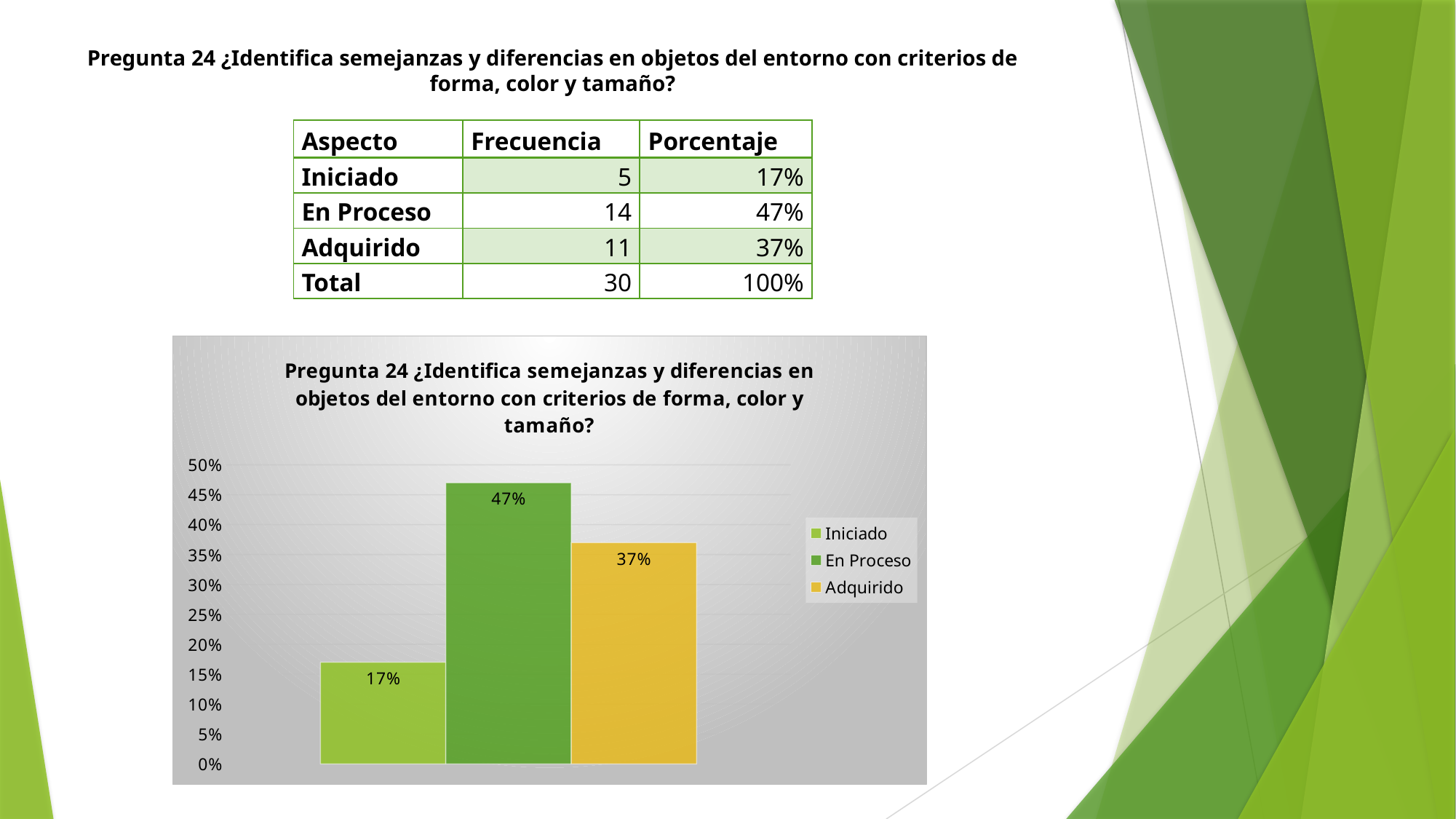
Is the value for En Proceso greater or less than 40%? greater Which is larger, the value for Iniciado or the value for Adquirido? Adquirido What kind of chart is shown on the slide? bar chart Which category has the lowest value in the chart? Iniciado What is the difference between the values for Adquirido and Iniciado? 20% Which category has the highest value in the chart? En Proceso What is the value for Adquirido in the chart? 37% What is the difference between the values for En Proceso and Adquirido? 10% What is the value for En Proceso in the chart? 47% How many bars are plotted in the chart? 3 How many entries does the chart legend list? 3 What is the value for Iniciado in the chart? 17%